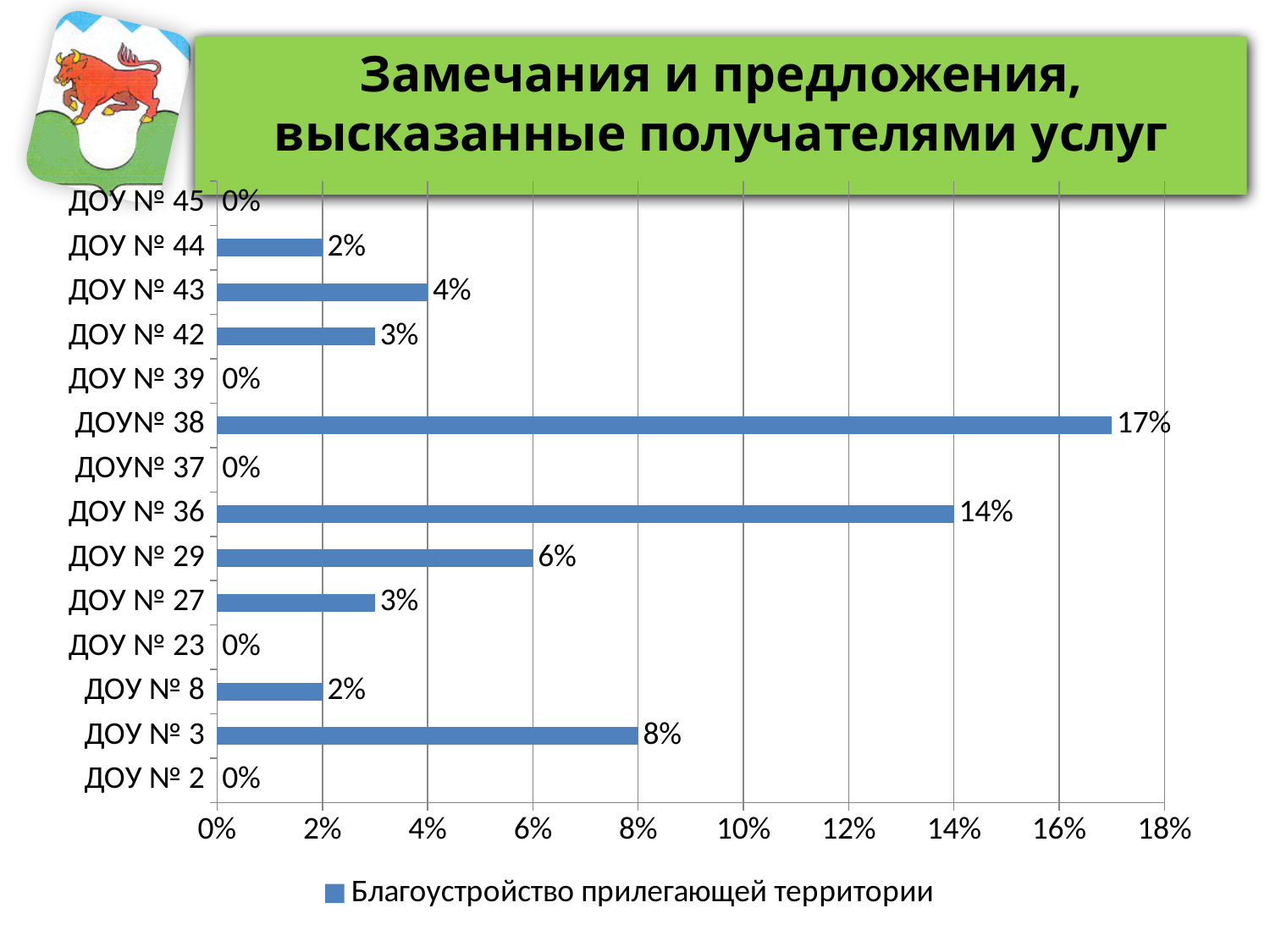
What value is shown for ДОУ № 36? 14% Which is larger, the value for ДОУ № 43 or the value for ДОУ № 42? ДОУ № 43 What value is shown for ДОУ № 3? 8% What kind of chart is shown on the slide? Bar chart What is the difference between the values for ДОУ № 3 and ДОУ № 29? 2% Which category has the highest value? ДОУ № 38 What value is shown for ДОУ № 29? 6% How many categories are shown on the chart? 14 What value is shown for ДОУ № 38? 17% What is the difference between the values for ДОУ № 38 and ДОУ № 36? 3% How many series does the legend list? 1 What is the legend entry of the series shown on the chart? Благоустройство прилегающей территории